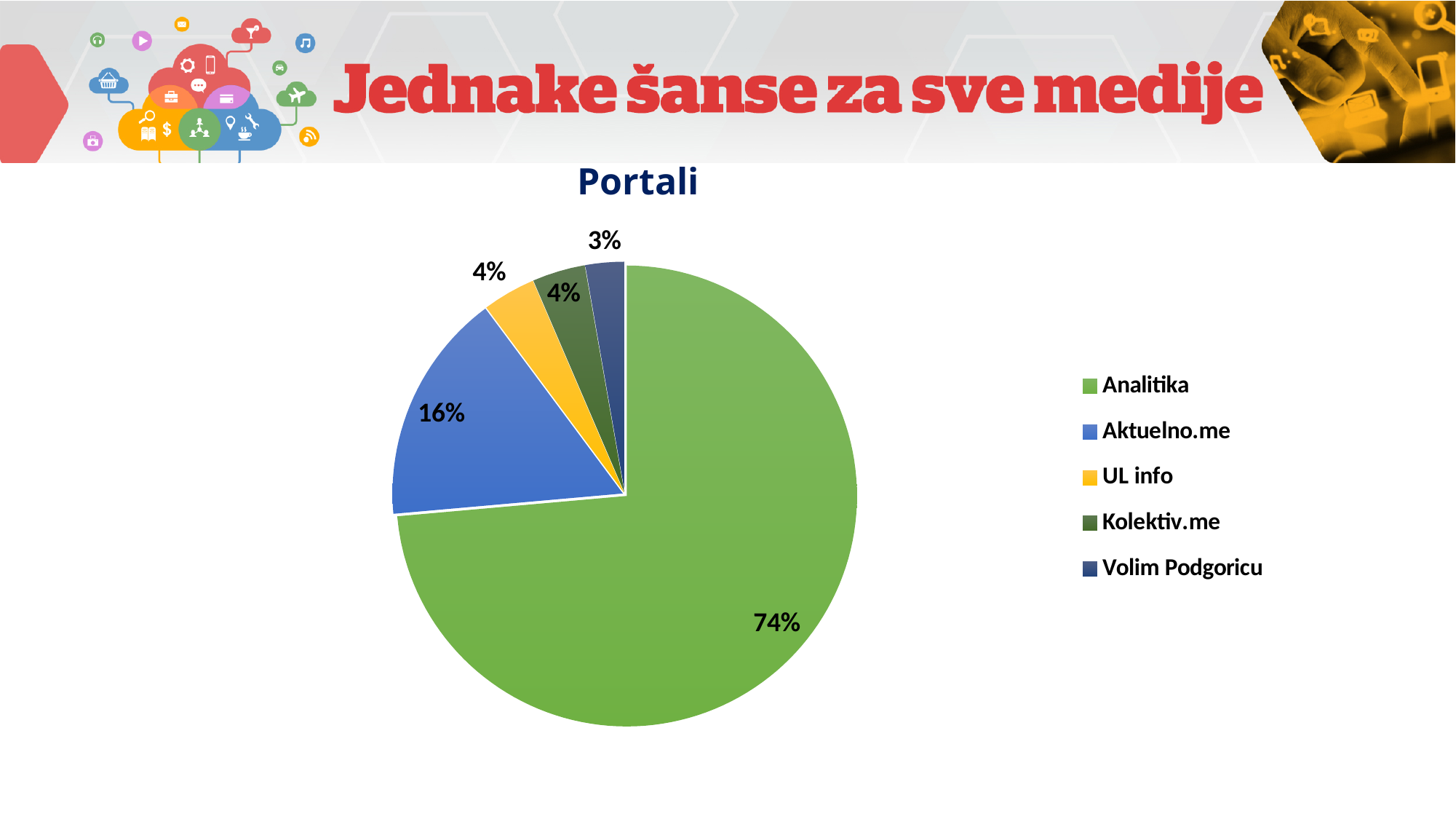
Which has a larger share, Aktuelno.me or Kolektiv.me? Aktuelno.me What share of the pie does Aktuelno.me have? 16% What is the title of the chart? Portali Which portal has the largest share of the pie? Analitika What type of chart is shown on the slide? pie chart What share of the pie does UL info have? 4% How many portals are shown in the pie chart? 5 What share of the pie does Volim Podgoricu have? 3% What share of the pie does Analitika have? 74% What colour is the slice for Analitika? green What is the difference in percentage points between Analitika and Aktuelno.me? 58 Which portal has the smallest share of the pie? Volim Podgoricu